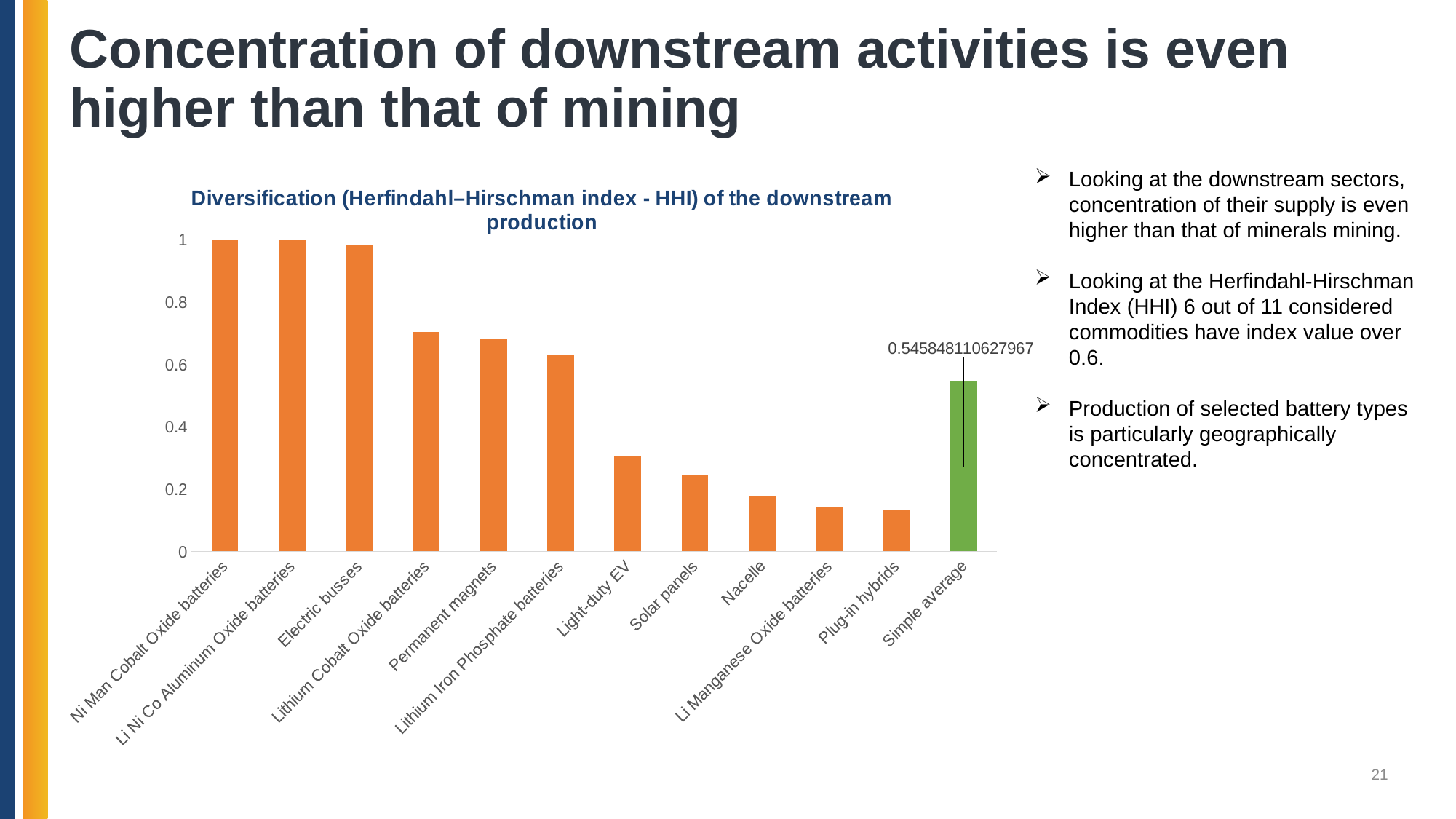
Is the value for Electric busses greater or less than 0.8? greater Is the value for Plug-in hybrids greater or less than 0.2? less What type of chart is shown on the slide? Bar chart Do the values of the orange bars rise or fall from left to right along the x axis? Fall Which has a lower value, Lithium Iron Phosphate batteries or Solar panels? Solar panels Is the value for Light-duty EV greater or less than 0.4? less Which bar in the chart is coloured green rather than orange? Simple average How many bars are plotted in the chart? 12 What is the value shown for Simple average? 0.545848110627967 Which has a higher value, Permanent magnets or Nacelle? Permanent magnets